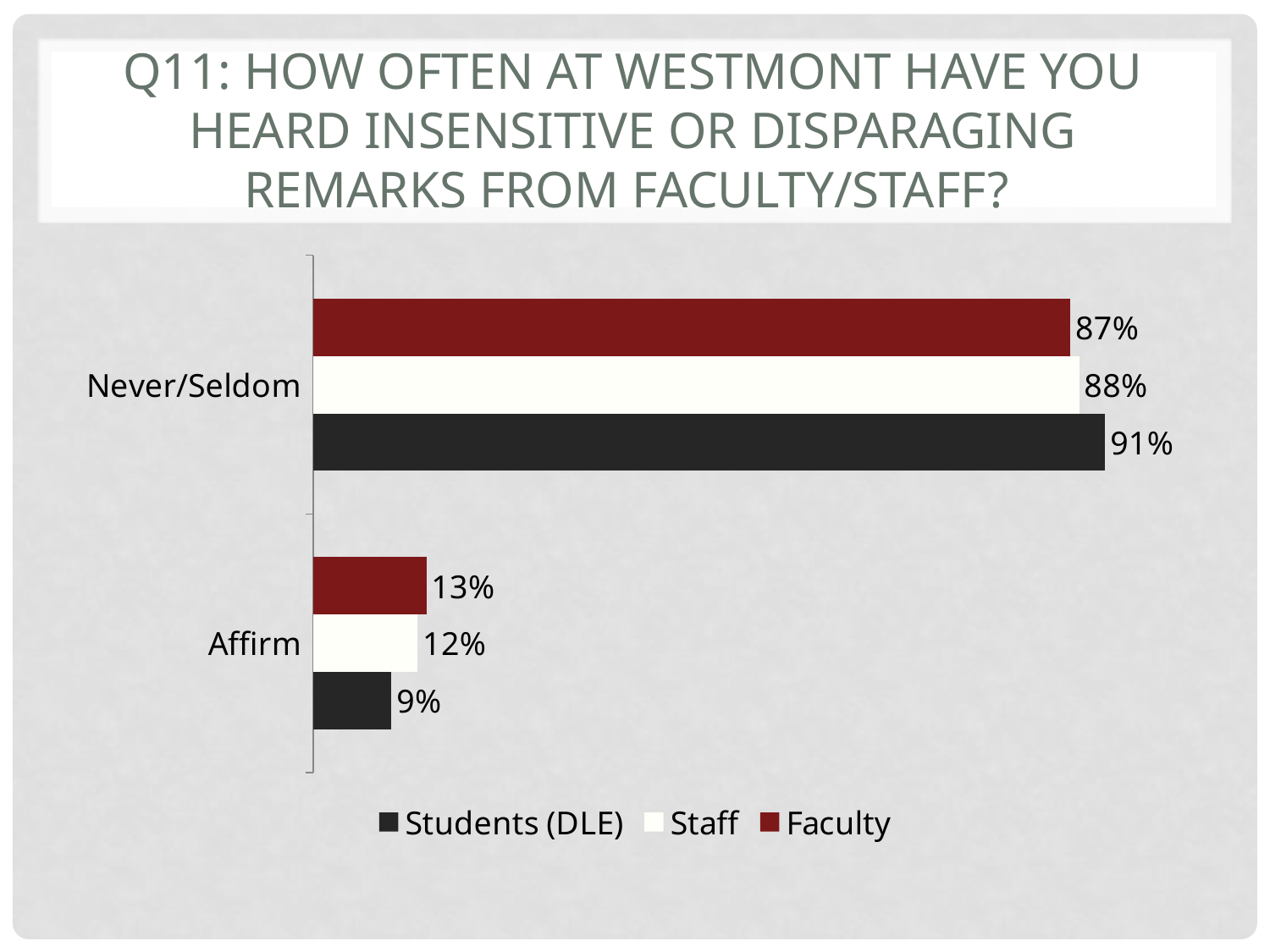
What percentage of Staff answered Affirm? 12% How many series does the legend list? 3 Which is larger: the Faculty percentage for Affirm or the Staff percentage for Affirm? Faculty What percentage of Students (DLE) answered Never/Seldom? 91% What percentage of Faculty answered Affirm? 13% Which group has the lowest percentage for Affirm? Students (DLE) Which colour represents Faculty in the legend? Dark red What kind of chart is shown on the slide? Bar chart What percentage of Staff answered Never/Seldom? 88% What is the difference between the Students (DLE) and Faculty percentages for Never/Seldom? 4% What is the difference between the Faculty and Students (DLE) percentages for Affirm? 4% Which group has the highest percentage for Never/Seldom? Students (DLE)